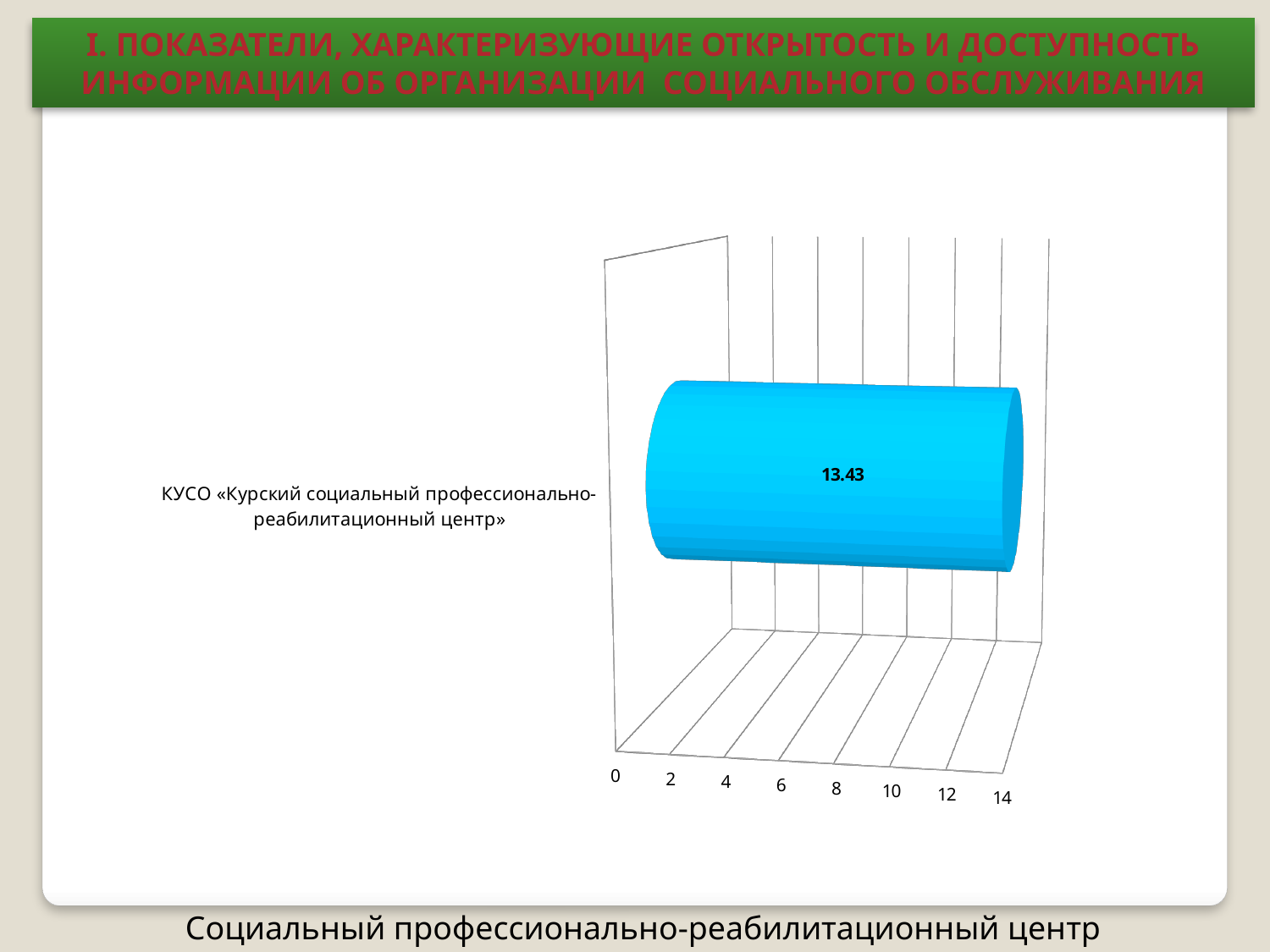
What is the highest value shown on the horizontal axis of the chart? 14 Is the value for КУСО «Курский социальный профессионально-реабилитационный центр» greater or less than 14? less What is the label of the only category in the chart? КУСО «Курский социальный профессионально-реабилитационный центр» Is the value for КУСО «Курский социальный профессионально-реабилитационный центр» greater or less than 10? greater Is the value for КУСО «Курский социальный профессионально-реабилитационный центр» greater or less than 12? greater How many categories are plotted in the chart? 1 What kind of chart is shown on the slide? bar chart What is the value shown for КУСО «Курский социальный профессионально-реабилитационный центр»? 13.43